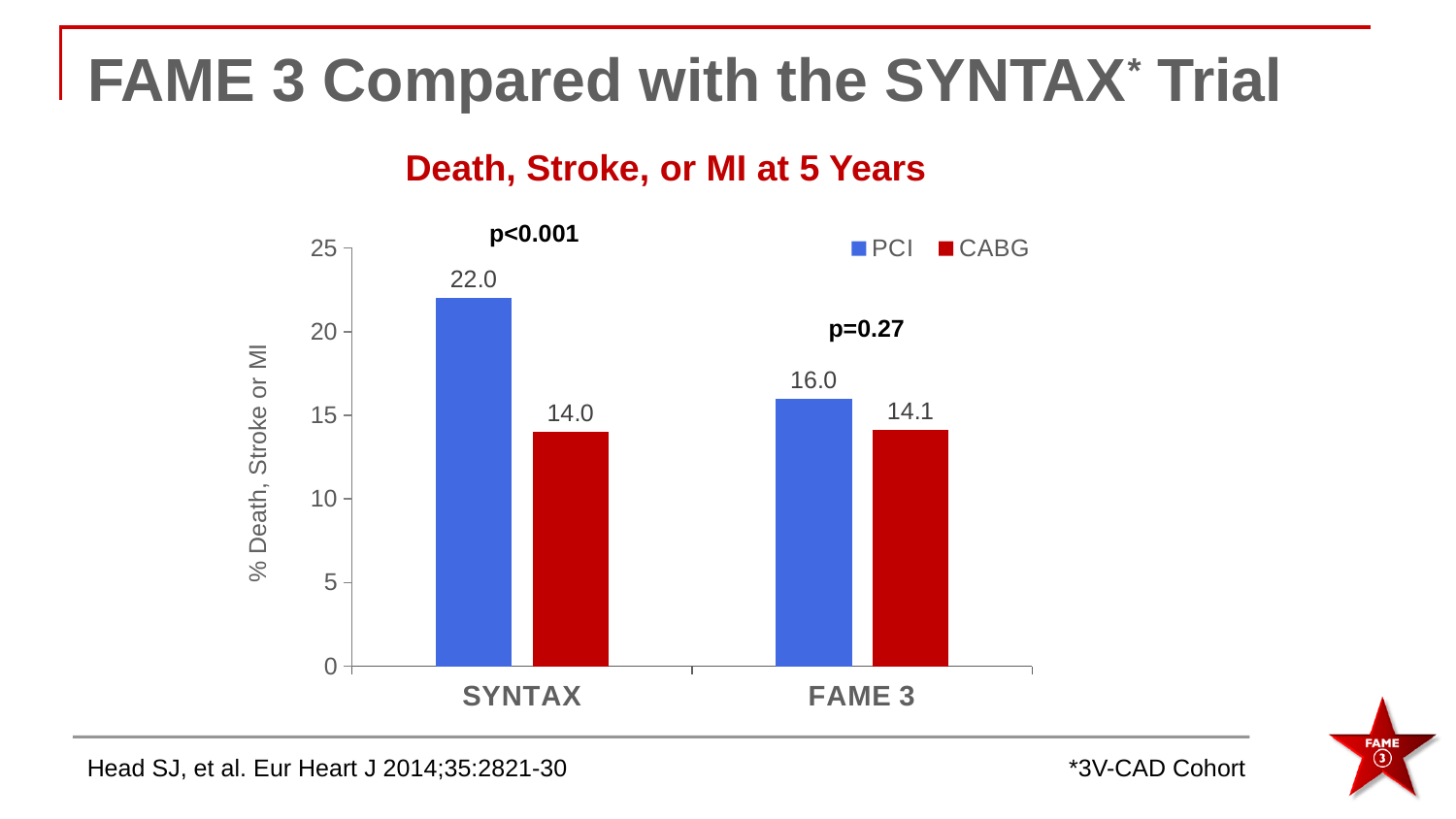
Which bar has the highest value on the chart? SYNTAX PCI Which trial has the lowest PCI value? FAME 3 What is the PCI value for FAME 3? 16.0 What is the PCI value for SYNTAX? 22.0 How many series does the legend list? 2 What is the p-value shown above the SYNTAX bars? p<0.001 What is the difference between the PCI values for SYNTAX and FAME 3? 6.0 What is the CABG value for FAME 3? 14.1 Which is larger, the PCI value for SYNTAX or the PCI value for FAME 3? SYNTAX What is the difference between the PCI and CABG values for SYNTAX? 8.0 What kind of chart is shown on the slide? Bar chart What is the CABG value for SYNTAX? 14.0